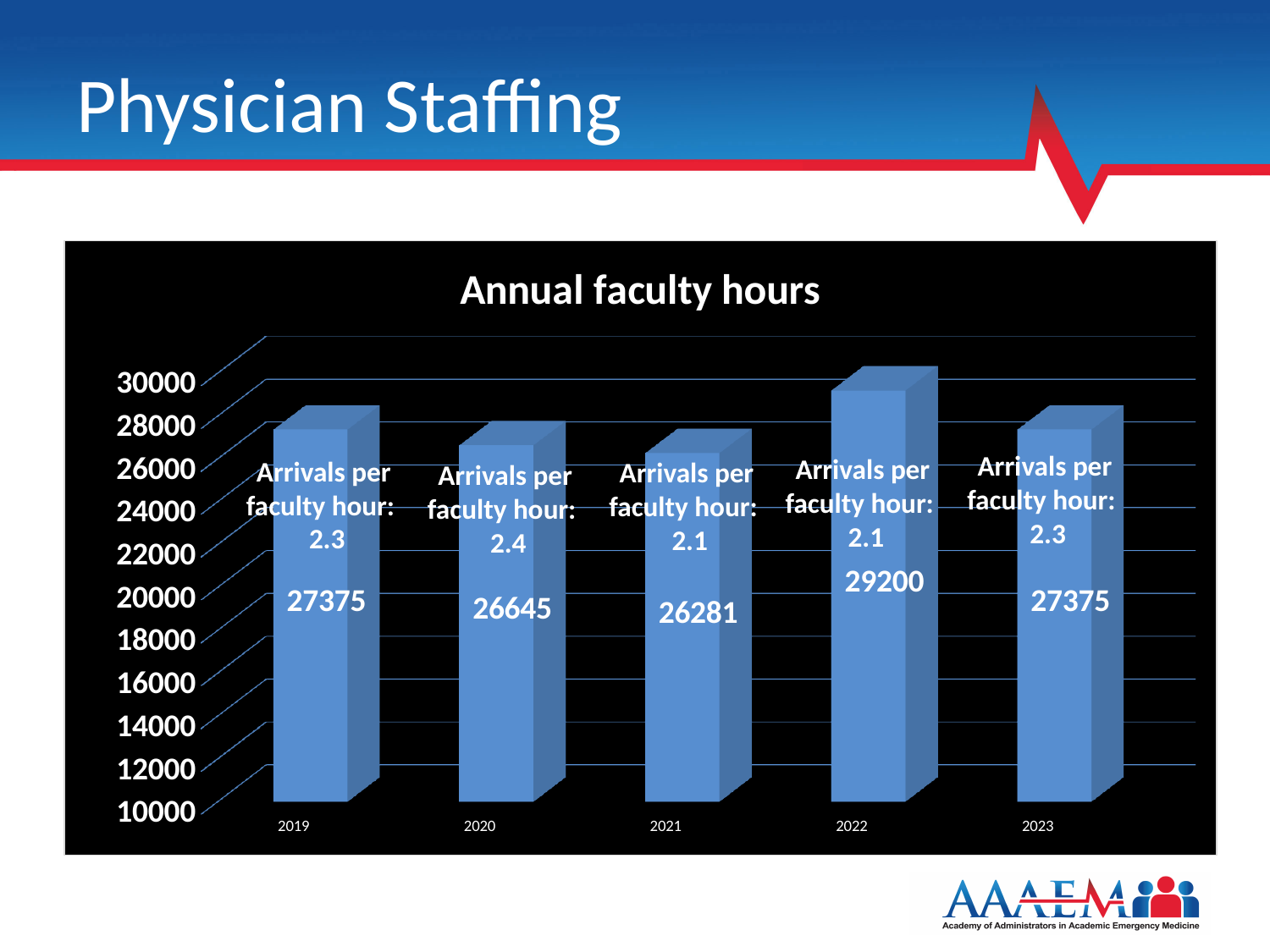
Which year has more annual faculty hours, 2020 or 2022? 2022 What is the difference in annual faculty hours between 2022 and 2021? 2919 What is the difference in annual faculty hours between 2019 and 2020? 730 Which year has the lowest annual faculty hours? 2021 What is the annual faculty hours value for 2022? 29200 What kind of chart is shown on the slide? Bar chart Which year has the highest annual faculty hours? 2022 Is the annual faculty hours value for 2022 greater or less than 28000? greater How many years are shown on the x axis of the chart? 5 What is the arrivals per faculty hour figure shown on the 2020 bar? 2.4 What is the title of the chart? Annual faculty hours What is the annual faculty hours value for 2021? 26281